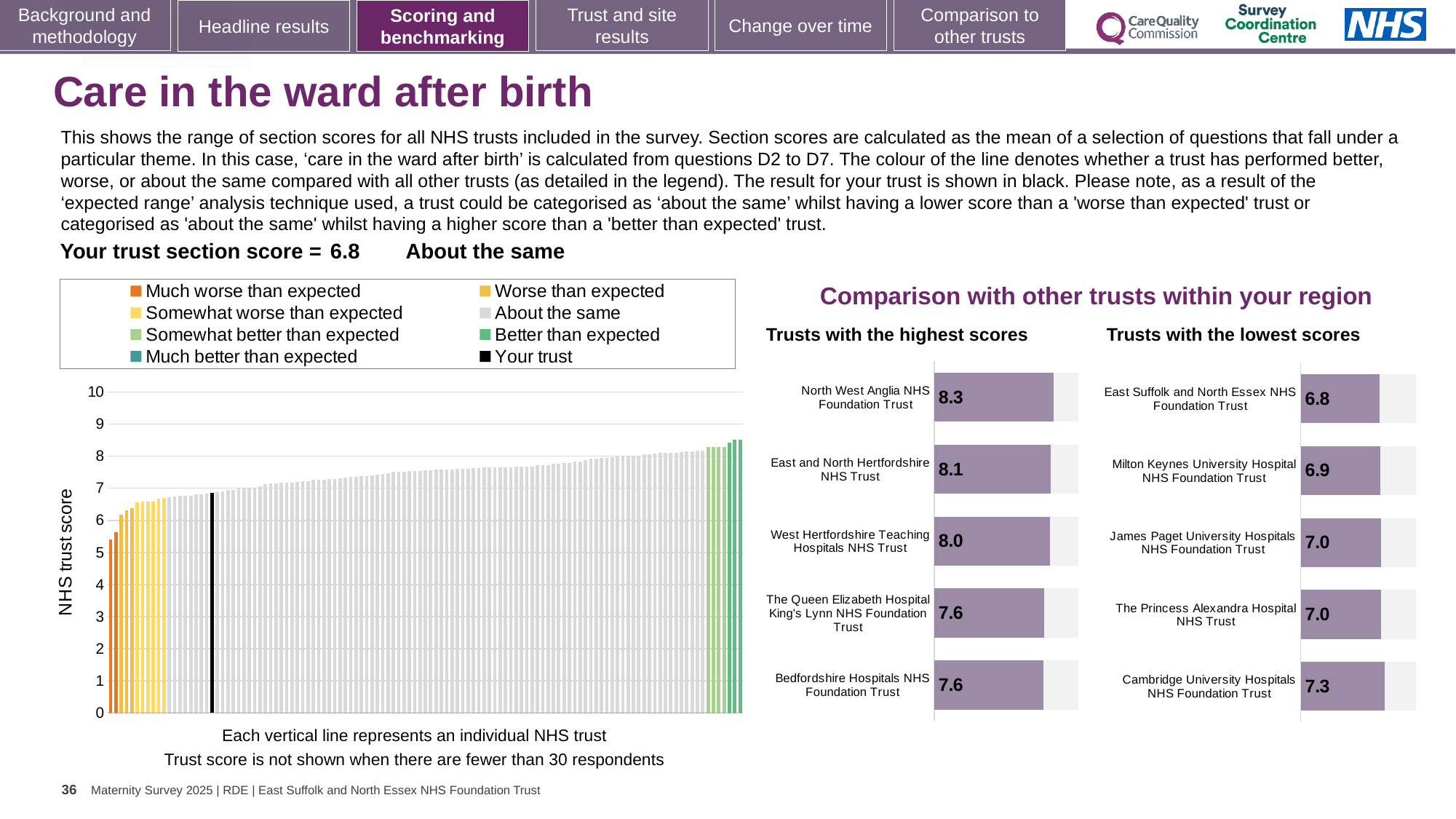
In the main chart on the left showing NHS trust scores, do the values rise or fall from left to right? rise How many trusts are shown in the 'Trusts with the lowest scores' chart? 5 In the 'Trusts with the highest scores' chart, which trust has the highest score? North West Anglia NHS Foundation Trust In the 'Trusts with the lowest scores' chart, what is the score for Cambridge University Hospitals NHS Foundation Trust? 7.3 How many entries does the legend of the main chart on the left list? 8 In the 'Trusts with the highest scores' chart, what is the score for West Hertfordshire Teaching Hospitals NHS Trust? 8.0 In the 'Trusts with the lowest scores' chart, which has the larger score: Milton Keynes University Hospital NHS Foundation Trust or Cambridge University Hospitals NHS Foundation Trust? Cambridge University Hospitals NHS Foundation Trust In the 'Trusts with the highest scores' chart, what is the score for North West Anglia NHS Foundation Trust? 8.3 In the 'Trusts with the highest scores' chart, what is the difference between the scores of North West Anglia NHS Foundation Trust and Bedfordshire Hospitals NHS Foundation Trust? 0.7 In the main chart on the left showing NHS trust scores, what is the score of the trust shown in black (your trust)? 6.8 In the 'Trusts with the lowest scores' chart, which trust has the lowest score? East Suffolk and North Essex NHS Foundation Trust What kind of chart is the main chart on the left showing NHS trust scores? bar chart